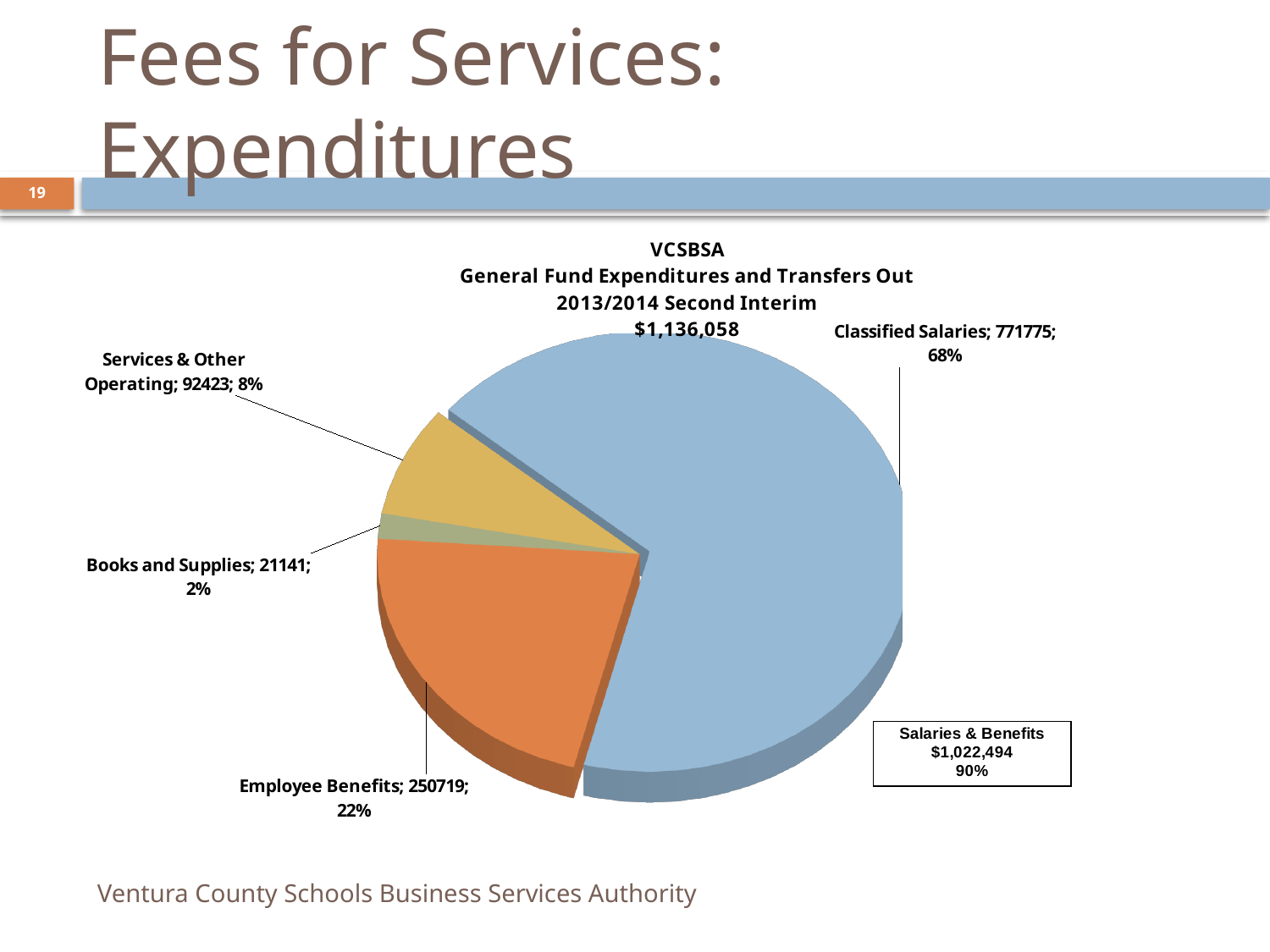
What total amount is shown in the chart title? $1,136,058 Which category has the largest slice? Classified Salaries What share of the pie does Employee Benefits represent? 22% What is the combined Salaries & Benefits amount shown in the box on the chart? $1,022,494 What is the value for Classified Salaries? 771775 What is the difference between the values for Classified Salaries and Employee Benefits? 521056 Which category has the smallest slice? Books and Supplies What type of chart is shown on the slide? pie chart What share of the pie does Books and Supplies represent? 2% What is the value for Services & Other Operating? 92423 How many categories are shown in the pie chart? 4 Which is larger, Services & Other Operating or Books and Supplies? Services & Other Operating